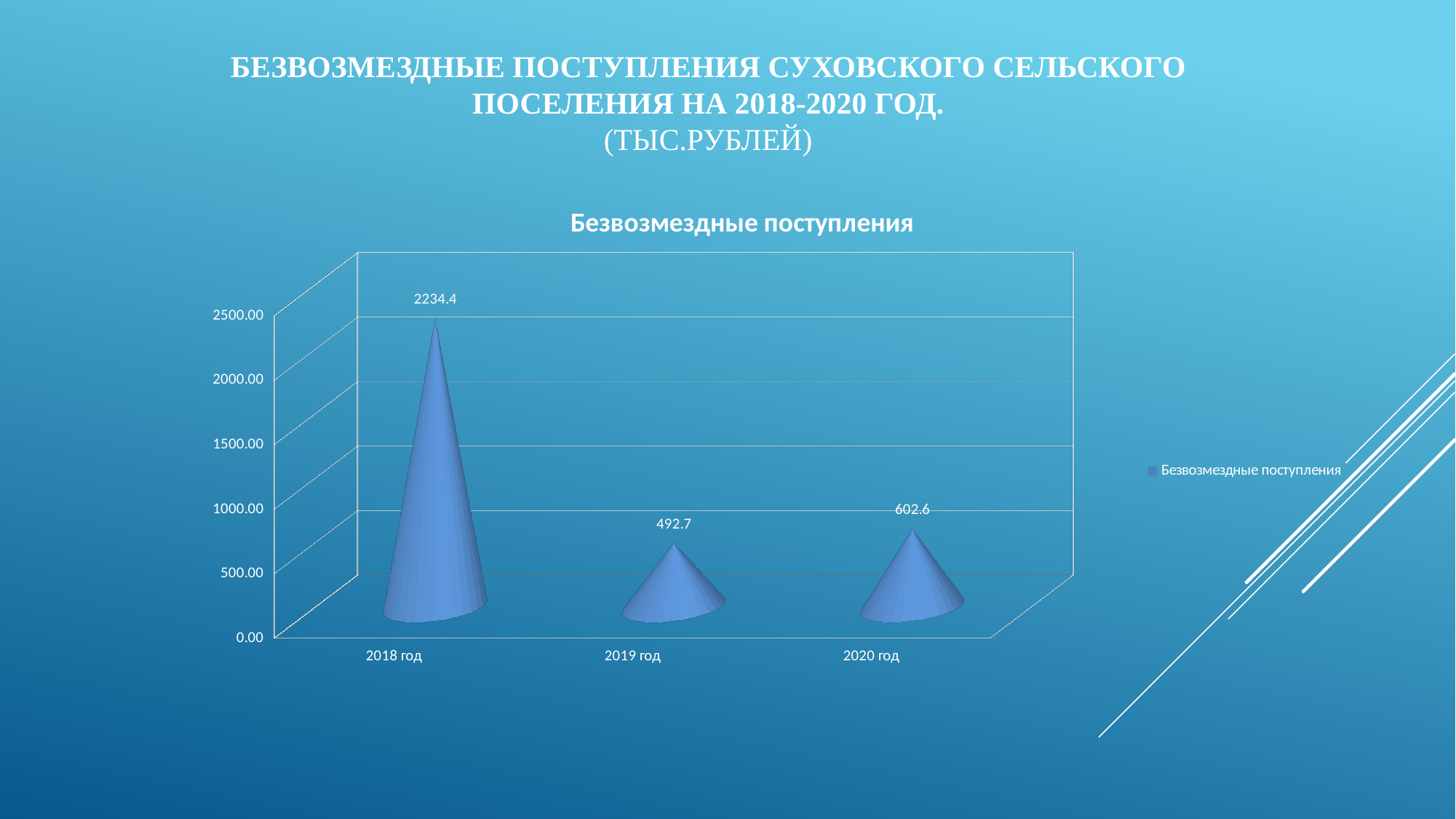
Which year has the lowest value? 2019 год What is the difference between the values for 2020 год and 2019 год? 109.9 Which is larger, the value for 2019 год or 2020 год? 2020 год What is the value for 2018 год? 2234.4 What is the title of the chart? Безвозмездные поступления How many categories are shown on the x axis? 3 Which year has the highest value? 2018 год What is the difference between the values for 2018 год and 2019 год? 1741.7 How many series does the legend list? 1 What is the value for 2019 год? 492.7 What kind of chart is shown? bar chart What is the value for 2020 год? 602.6